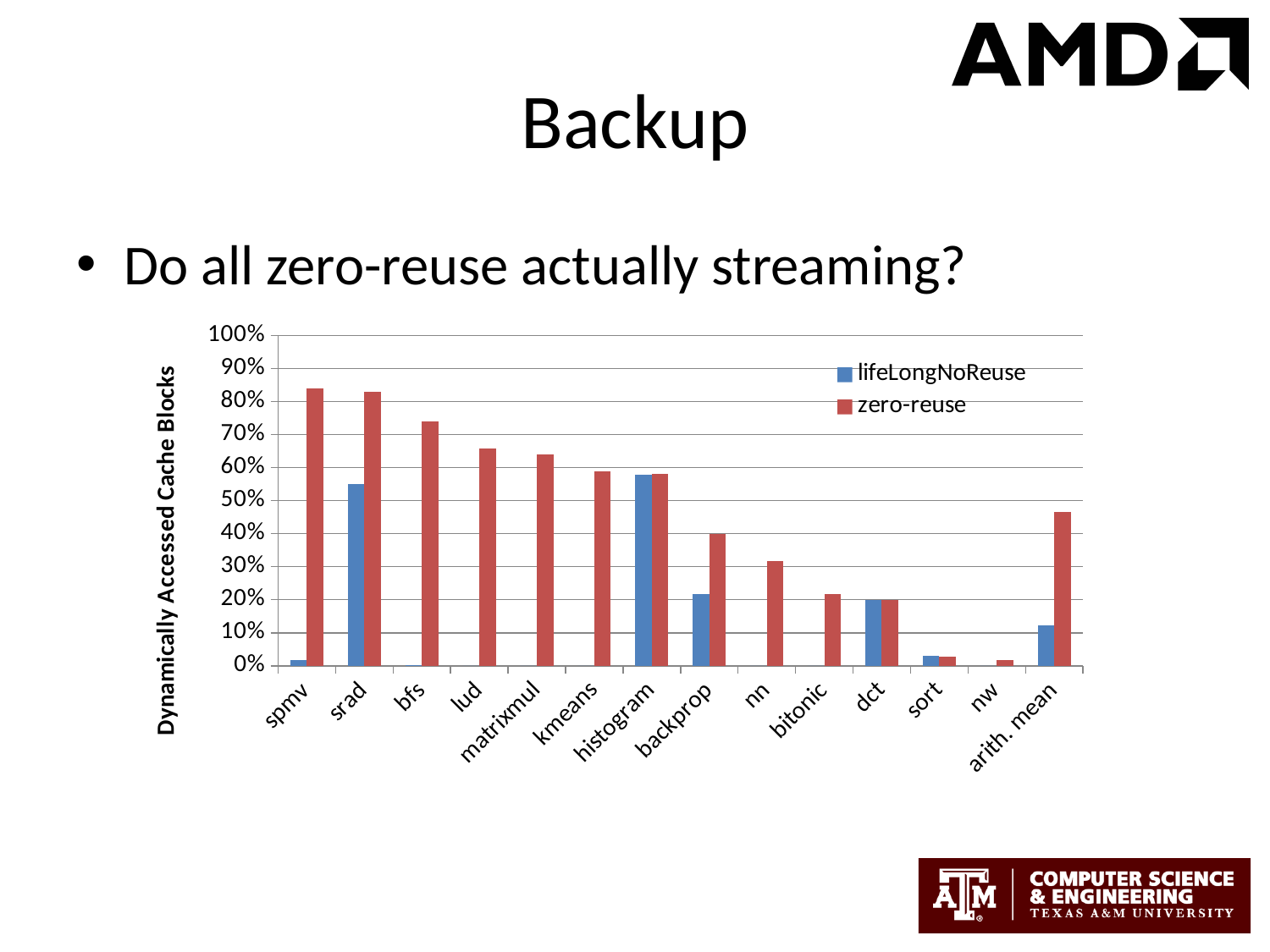
What kind of chart is shown on the slide? bar chart Which has the larger zero-reuse value, nn or bitonic? nn How many categories are shown on the x axis of the chart? 14 Is the lifeLongNoReuse value for srad greater or less than 50%? greater Is the zero-reuse value for arith. mean greater or less than 40%? greater Is the zero-reuse value for bfs greater or less than 70%? greater How many series does the chart legend list? 2 Which series is drawn in red in the chart? zero-reuse For spmv, which series has the larger value, lifeLongNoReuse or zero-reuse? zero-reuse What is the title of the chart's y axis? Dynamically Accessed Cache Blocks